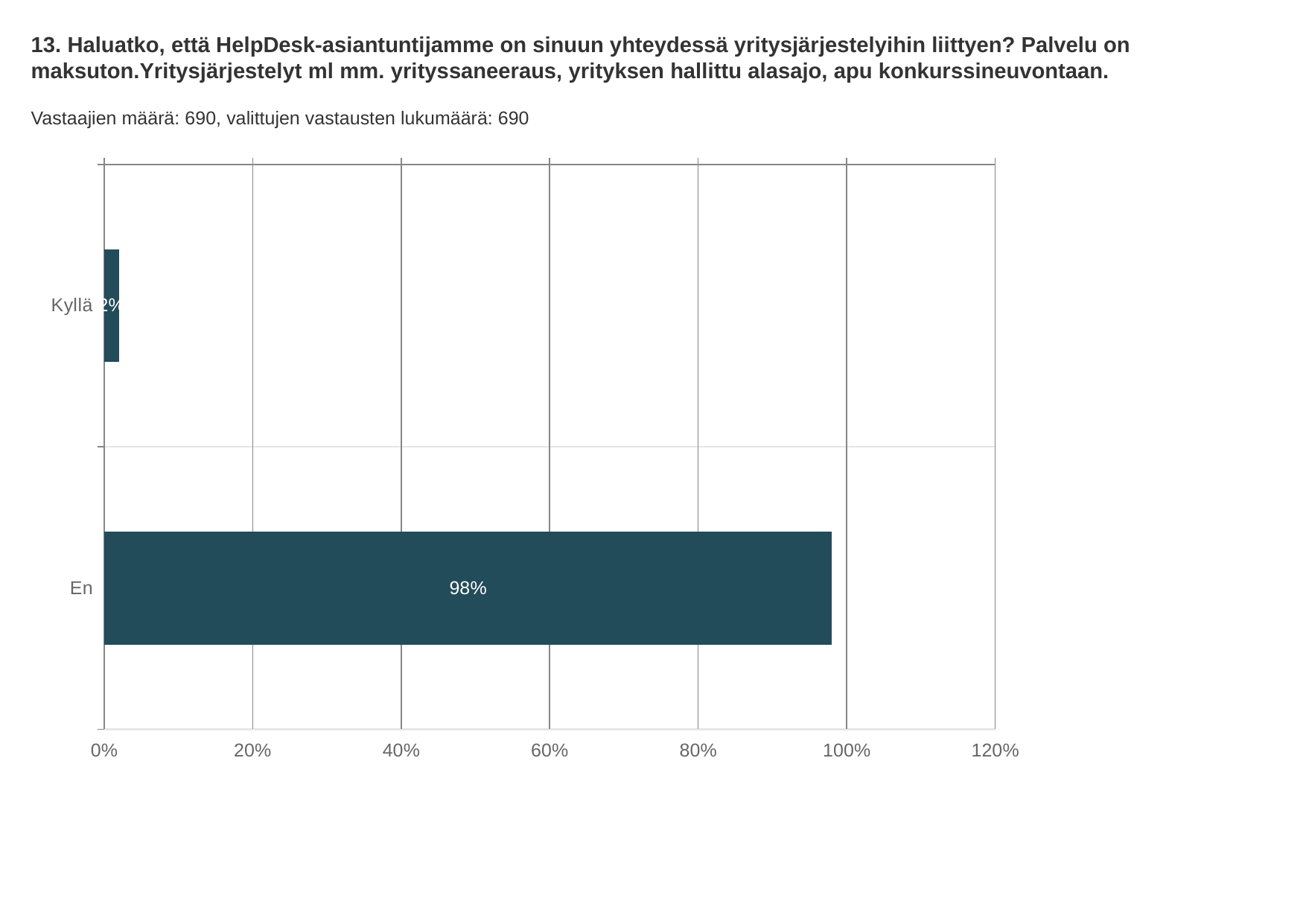
Is the value for Kyllä greater or less than 20%? less What is the highest tick value shown on the x axis? 120% What is the difference between the values for En and Kyllä? 96% What is the value for En? 98% How many categories are shown in the chart? 2 What is the value for Kyllä? 2% Which category has the highest value? En Which category has the lowest value? Kyllä How many respondents (Vastaajien määrä) are stated on the slide? 690 What kind of chart is shown on the slide? bar chart Is the value for En greater or less than 80%? greater Which is larger, the value for En or the value for Kyllä? En